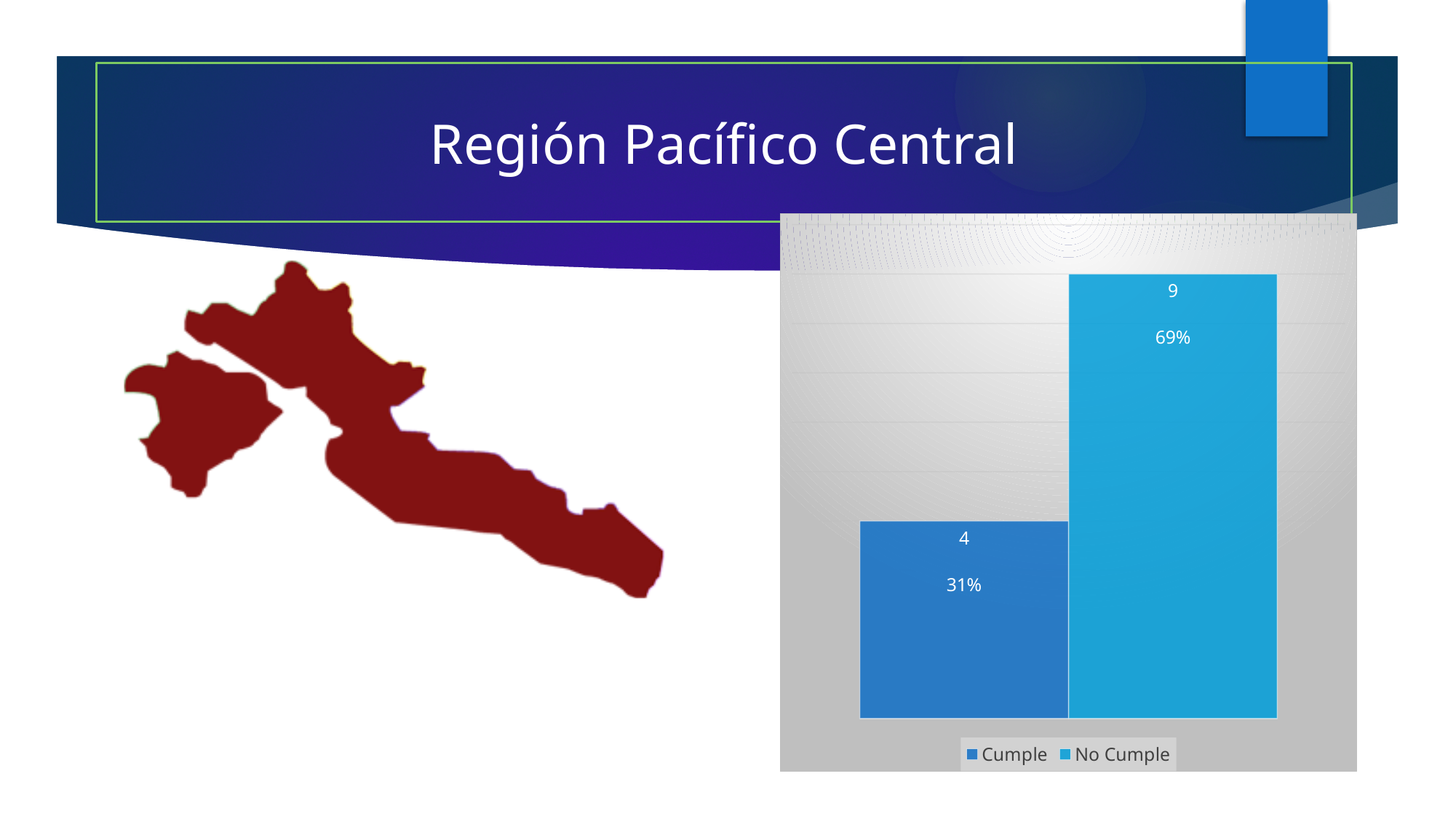
What is the title of the slide containing the chart? Región Pacífico Central What percentage is shown for Cumple? 31% Which series has the lower value? Cumple What kind of chart is shown on the slide? bar chart What is the difference between the No Cumple and Cumple values? 5 How many series does the legend list? 2 What is the total of the Cumple and No Cumple values? 13 What percentage is shown for No Cumple? 69% Which series has the higher value, Cumple or No Cumple? No Cumple What value is shown for No Cumple? 9 Is the value for Cumple larger or smaller than the value for No Cumple? smaller What value is shown for Cumple? 4